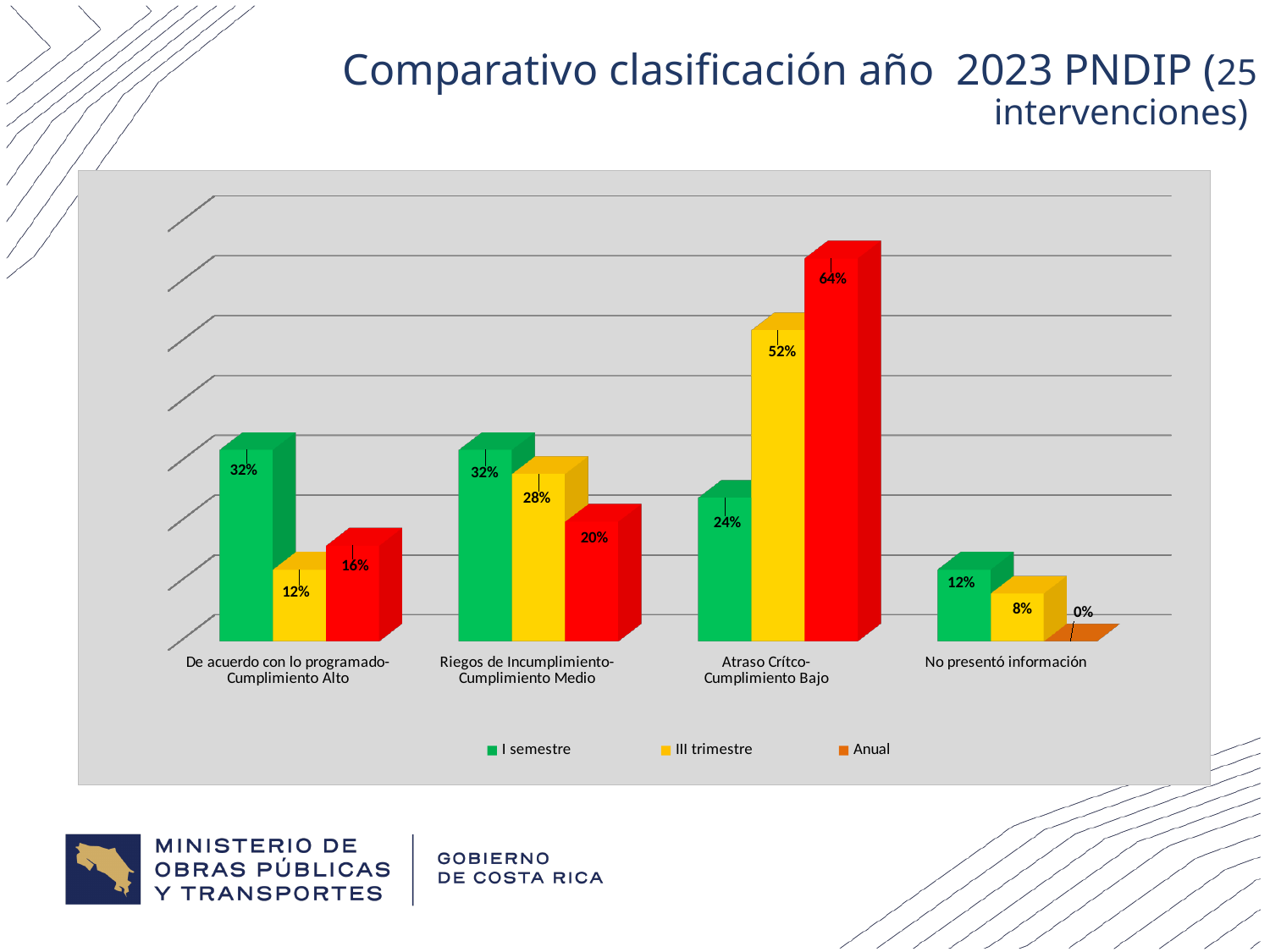
What are the three series listed in the legend? I semestre, III trimestre, Anual What is the difference between the Anual and I semestre values for Atraso Crítco-Cumplimiento Bajo? 40% What is the I semestre value for No presentó información? 12% What is the Anual value for No presentó información? 0% What is the Anual value for Atraso Crítco-Cumplimiento Bajo? 64% Which category has the lowest Anual value? No presentó información What is the III trimestre value for Riegos de Incumplimiento-Cumplimiento Medio? 28% How many categories are shown on the x axis? 4 Which is larger for De acuerdo con lo programado-Cumplimiento Alto: the III trimestre value or the Anual value? Anual What type of chart is shown on the slide? bar chart How many series does the legend list? 3 Which category has the highest III trimestre value? Atraso Crítco-Cumplimiento Bajo